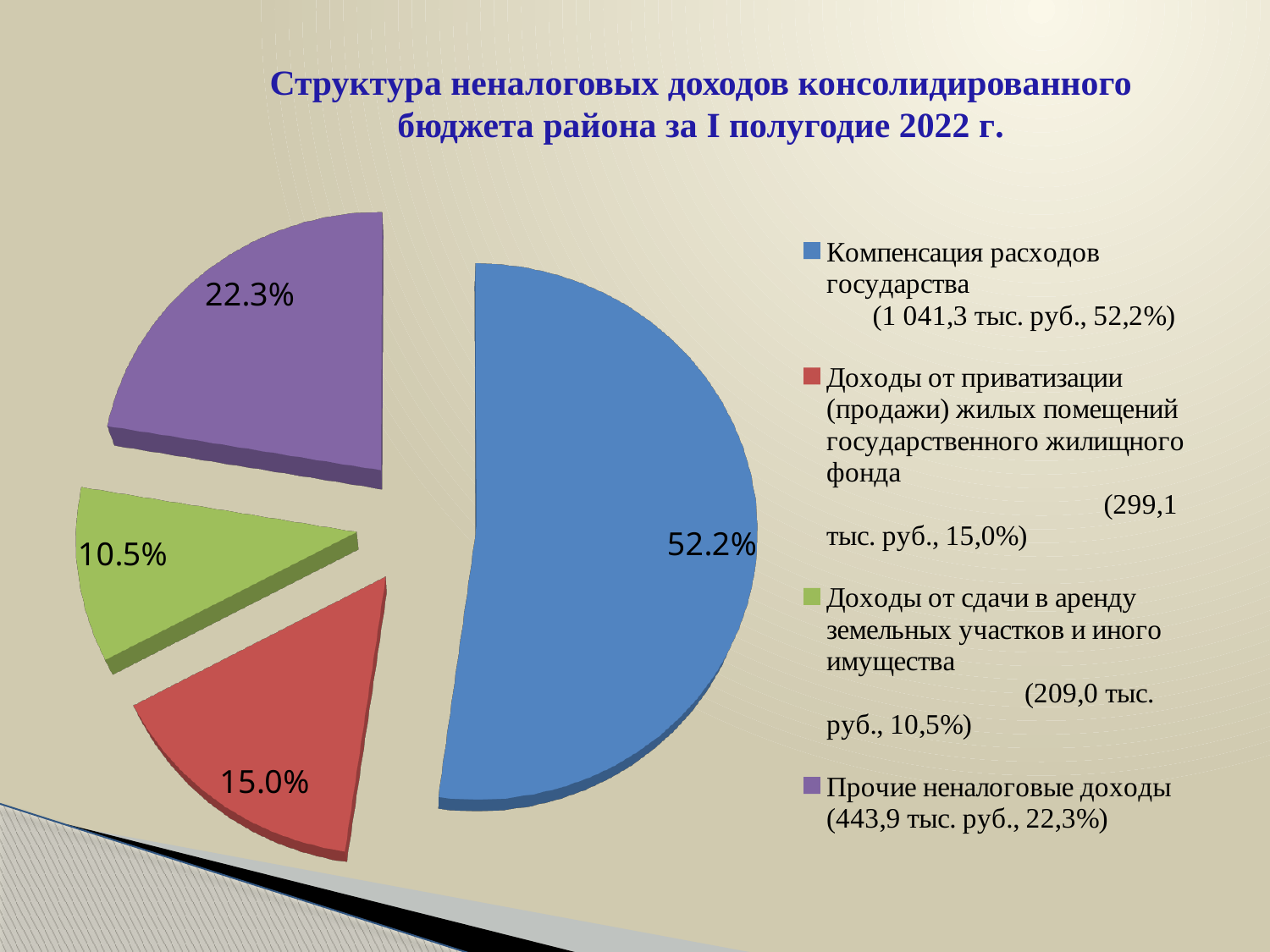
Which category has the smallest share of the pie? Доходы от сдачи в аренду земельных участков и иного имущества What percentage is shown for "Прочие неналоговые доходы"? 22.3% What colour is the slice for "Компенсация расходов государства"? Blue What is the difference in percentage points between "Прочие неналоговые доходы" and "Доходы от приватизации (продажи) жилых помещений государственного жилищного фонда"? 7.3 According to the legend, what amount in тыс. руб. corresponds to "Прочие неналоговые доходы"? 443,9 тыс. руб. Which category has the largest share of the pie? Компенсация расходов государства What percentage is shown for "Доходы от приватизации (продажи) жилых помещений государственного жилищного фонда"? 15.0% What share of the pie does "Компенсация расходов государства" take? 52.2% How many slices does the pie chart have? 4 What kind of chart is shown on the slide? Pie chart What percentage is shown for "Доходы от сдачи в аренду земельных участков и иного имущества"? 10.5% Which is larger: the share for "Прочие неналоговые доходы" or the share for "Доходы от сдачи в аренду земельных участков и иного имущества"? Прочие неналоговые доходы